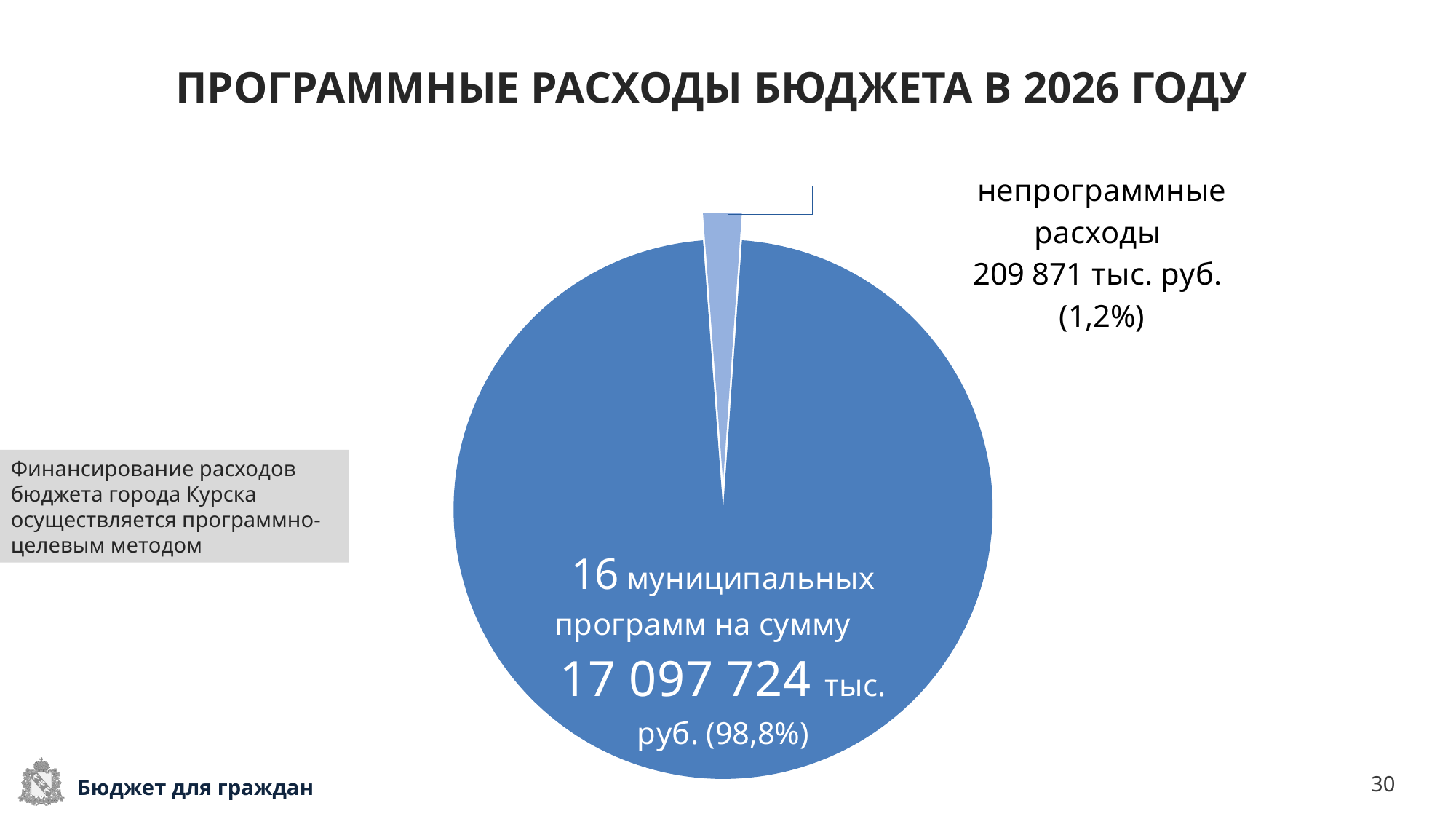
By how much do the municipal program expenses exceed the non-programmatic expenses, in тыс. руб.? 16 887 853 тыс. руб. What share of the pie do the municipal programs represent? 98,8% What is the total amount of the 16 municipal programs shown in the large slice? 17 097 724 тыс. руб. How many municipal programs are mentioned in the large slice of the pie? 16 What kind of chart is shown on the slide? pie chart Which slice of the pie is the smallest? непрограммные расходы What is the value of the non-programmatic expenses (непрограммные расходы) slice? 209 871 тыс. руб. What share of the pie do the non-programmatic expenses (непрограммные расходы) represent? 1,2% Which is larger: the programmatic expenses (municipal programs) or the non-programmatic expenses? programmatic expenses (municipal programs) Which slice of the pie is the largest? 16 муниципальных программ (programmatic expenses) What is the title of the slide containing the pie chart? ПРОГРАММНЫЕ РАСХОДЫ БЮДЖЕТА В 2026 ГОДУ How many slices does the pie chart have? 2